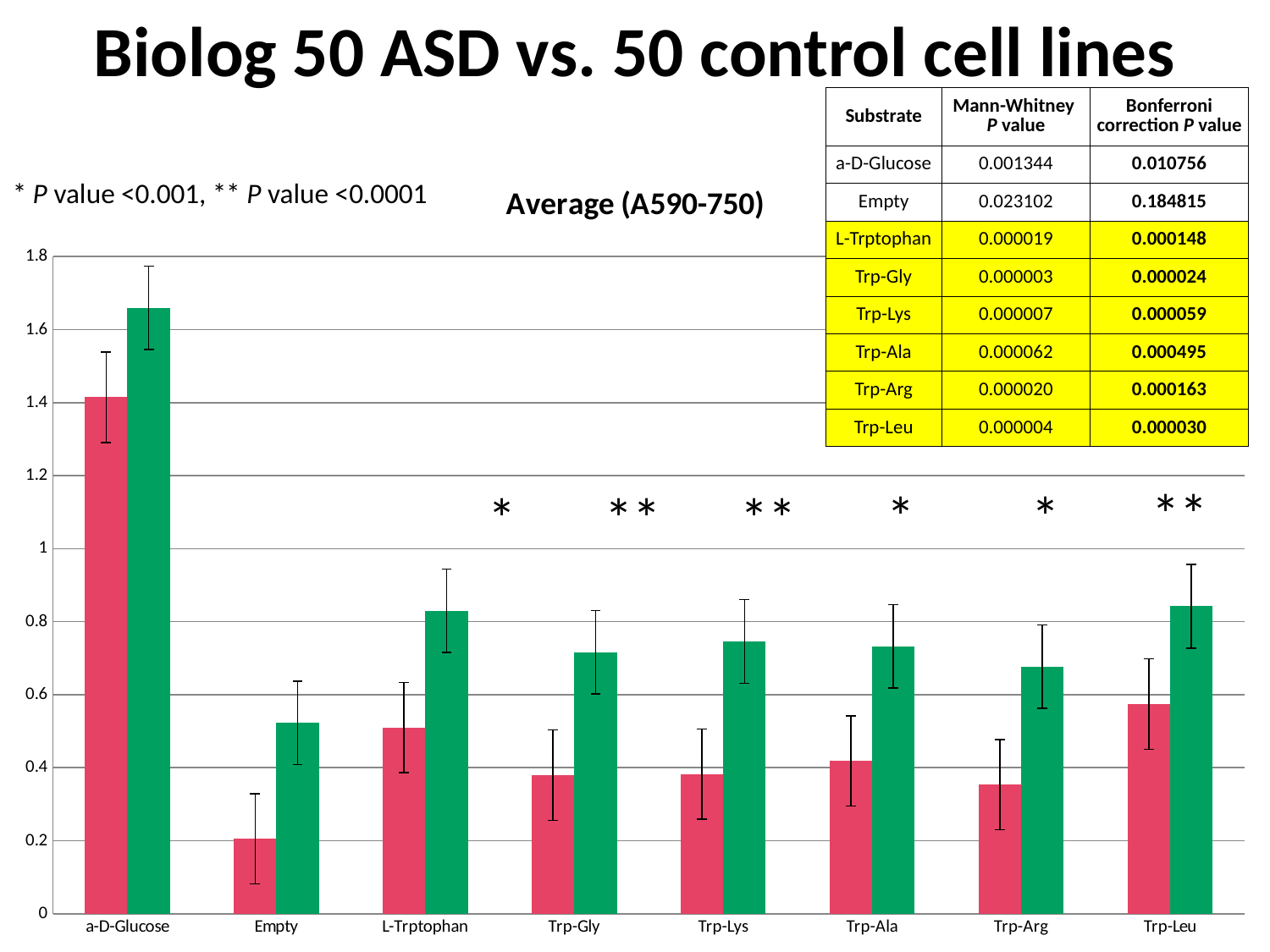
Is the green bar for a-D-Glucose greater or less than 1.4? greater Which red bar is taller, Trp-Leu or Empty? Trp-Leu Is the green bar for Trp-Arg greater or less than 0.8? less How many substrate categories are shown on the x axis of the chart? 8 Which category has the tallest green bar? a-D-Glucose Is the green bar for L-Trptophan greater or less than 0.6? greater For Trp-Gly, which bar is taller, the red bar or the green bar? the green bar What kind of chart is shown on the slide? bar chart Which category has the shortest red bar? Empty What is the title of the chart? Average (A590-750)